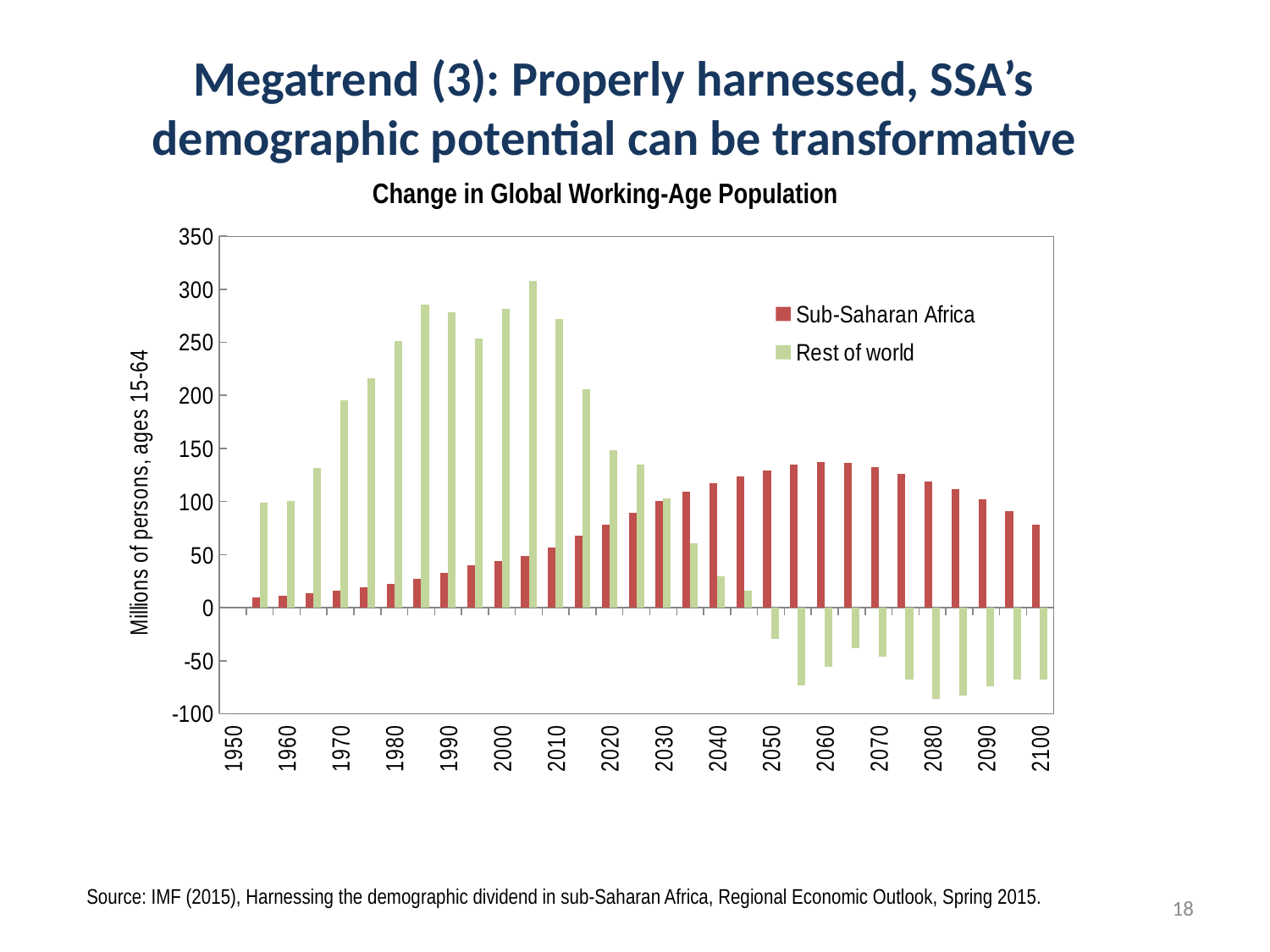
Which series has the larger value in 2005, Sub-Saharan Africa or Rest of world? Rest of world What is the title of the chart? Change in Global Working-Age Population How many year labels are shown along the x axis? 16 Which series has the larger value in 2060, Sub-Saharan Africa or Rest of world? Sub-Saharan Africa What kind of chart is shown on the slide? Bar chart Is the Rest of world value for 2005 greater or less than 250? greater How many series does the legend list? 2 Is the Rest of world value for 2050 greater or less than 0? less What is the label on the vertical axis? Millions of persons, ages 15-64 In which year does the Rest of world series reach its highest value? 2005 Do the Rest of world values rise or fall from 2005 to 2100? fall Is the Sub-Saharan Africa value for 2100 greater or less than 100? less